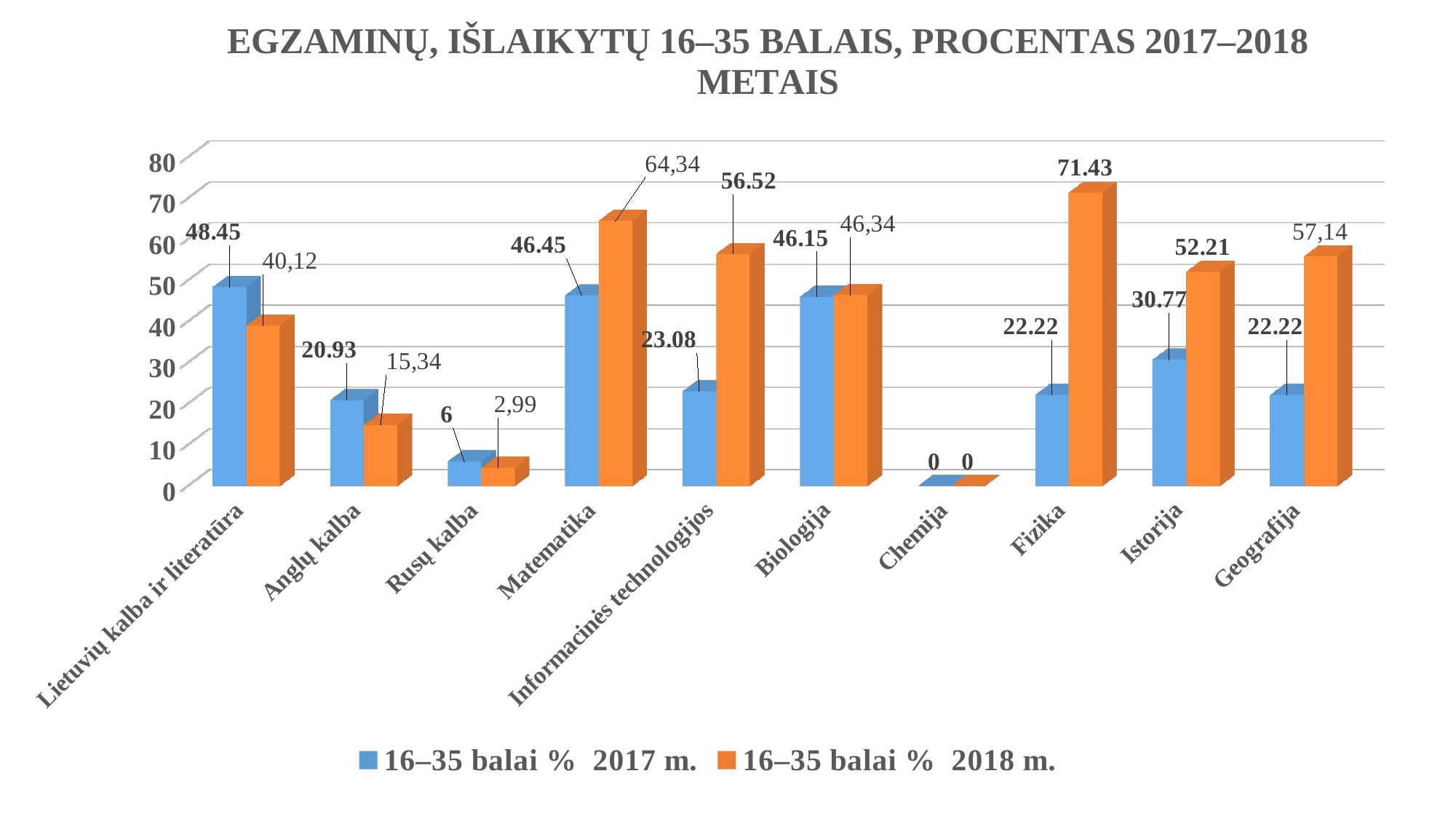
Is the value for Geografija in the 2018 m. series greater or less than 50? greater How many exam subjects (categories) are shown on the x axis? 10 Which subject has the lowest value in the 2017 m. series? Chemija What type of chart is shown on the slide? Bar chart What is the value for Rusų kalba in the 2018 m. series? 2,99 How many series does the legend list? 2 What is the value for Matematika in the 2018 m. series? 64,34 What colour represents the 2017 m. series? Blue Which subject has the highest value in the 2018 m. series? Fizika For Informacinės technologijos, which series has the larger value, 2017 m. or 2018 m.? 2018 m. What is the value for Lietuvių kalba ir literatūra in the 2017 m. series? 48.45 What is the difference between the 2018 m. and 2017 m. values for Fizika? 49.21